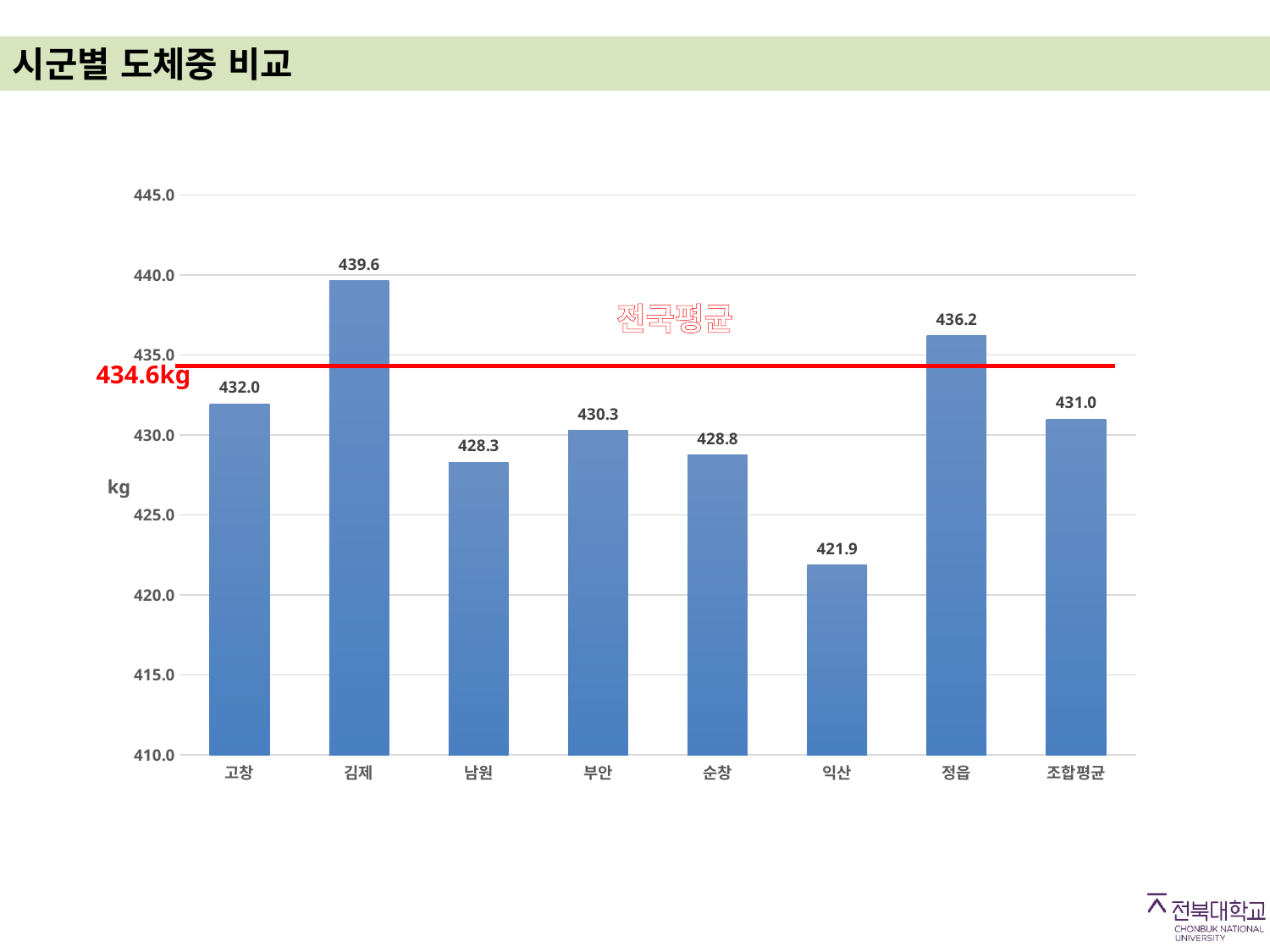
What kind of chart is shown on the slide? bar chart What is the difference between the values for 김제 and 익산? 17.7 What is the value for 조합평균? 431.0 What is the title of the slide? 시군별 도체중 비교 Which is larger, the value for 고창 or the value for 정읍? 정읍 Which category has the lowest value? 익산 What value does the red horizontal line (전국평균) mark? 434.6kg How many categories are shown on the x axis? 8 What is the value for 익산? 421.9 Is the value for 남원 greater or less than 430.0? less What is the value for 김제? 439.6 Which category has the highest value? 김제